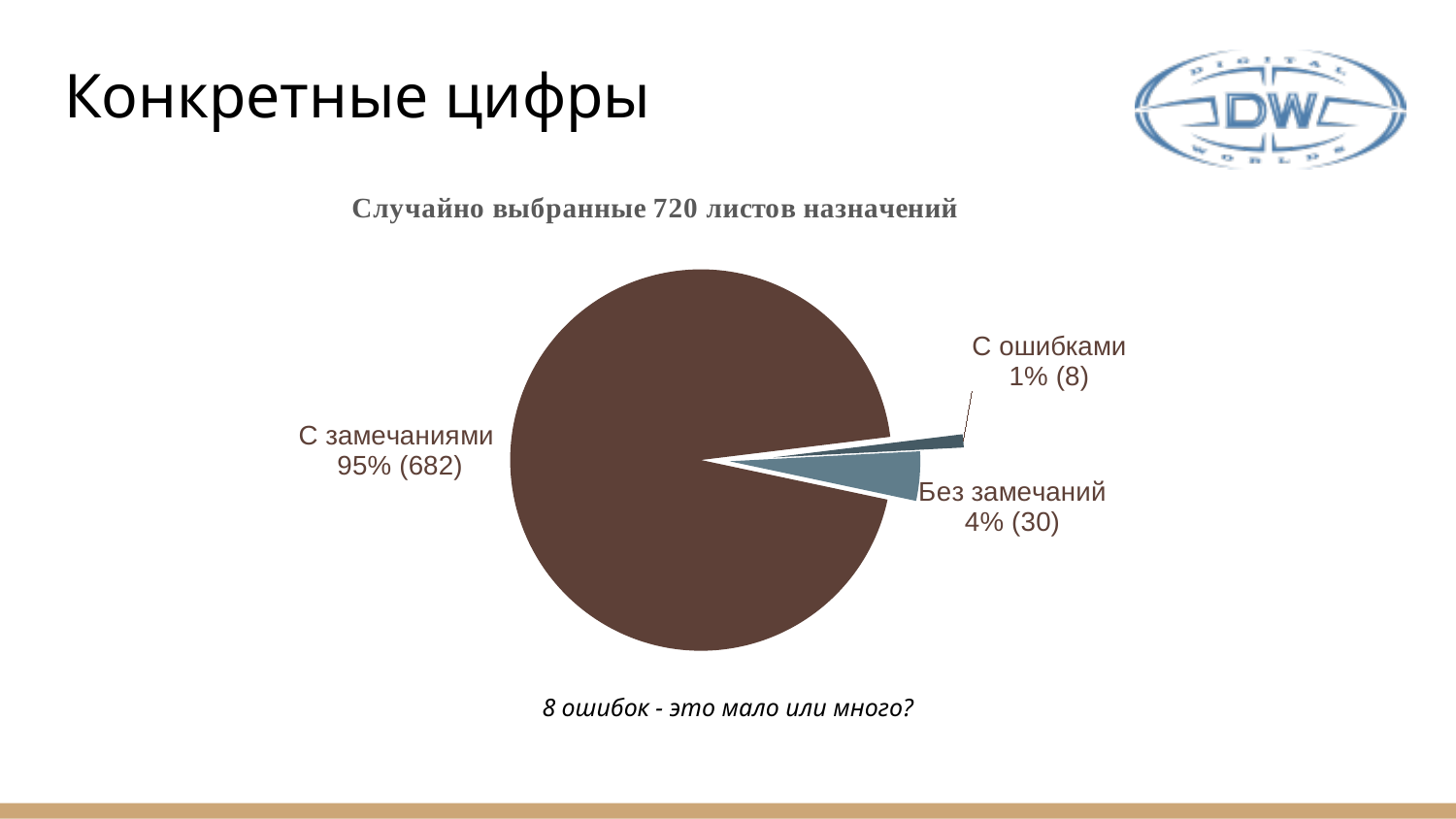
How many slices does the pie chart have? 3 What share of the pie does the slice "С ошибками" represent? 1% What share of the pie does the slice "Без замечаний" represent? 4% Which category has the smallest slice of the pie? С ошибками How many sheets are in the "Без замечаний" category? 30 How many sheets are in the "С замечаниями" category? 682 What is the title of the chart? Случайно выбранные 720 листов назначений How many sheets are in the "С ошибками" category? 8 What share of the pie does the slice "С замечаниями" represent? 95% What is the difference in count between "Без замечаний" and "С ошибками"? 22 Which category has the largest slice of the pie? С замечаниями What kind of chart is shown on the slide? Pie chart